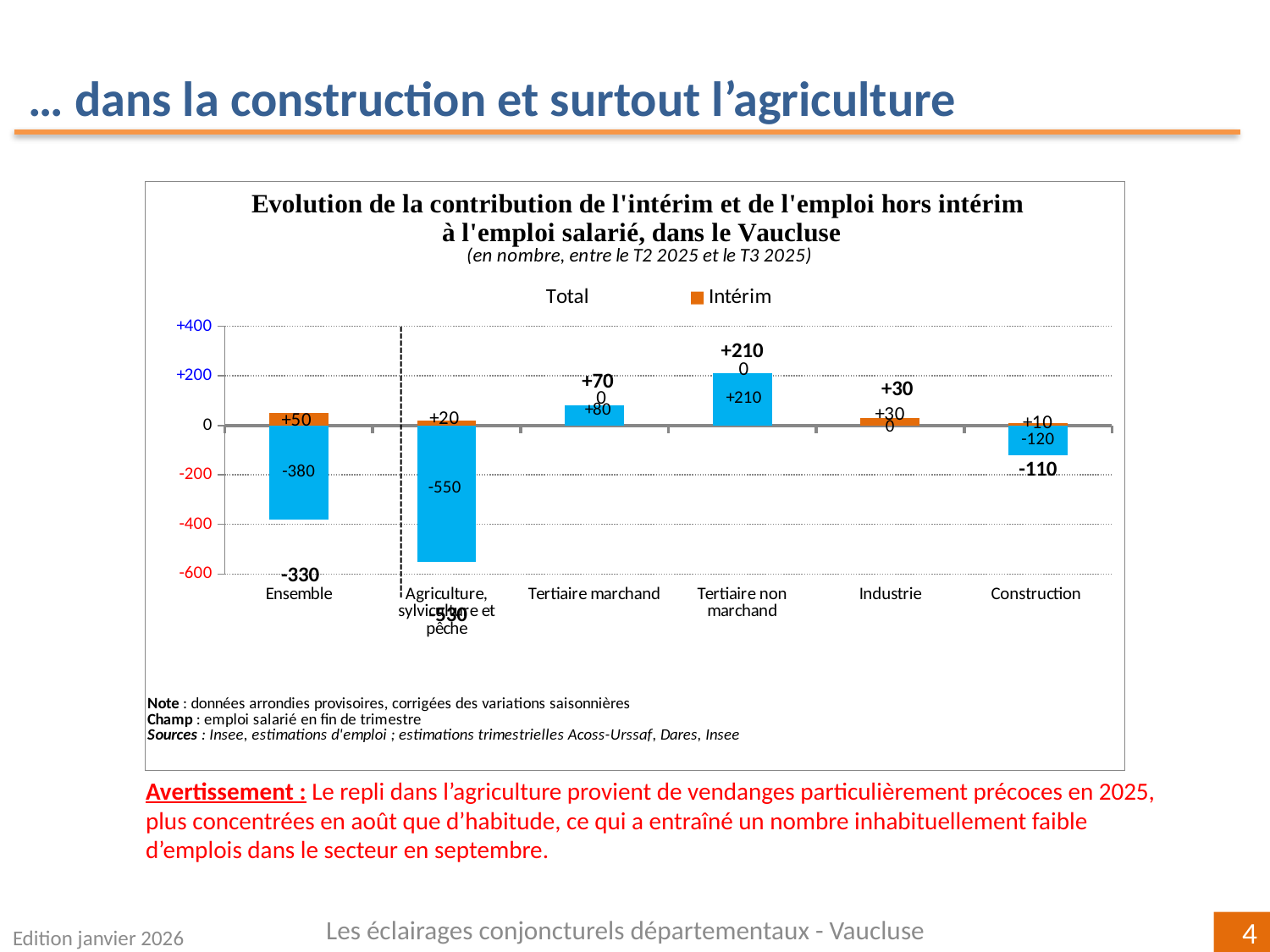
What is the Intérim value shown for Industrie? +30 Which has the larger blue bar value, Tertiaire marchand or Tertiaire non marchand? Tertiaire non marchand What is the bold total value shown for Tertiaire marchand? +70 What is the Intérim value shown for Ensemble? +50 What is the difference between the Intérim value for Ensemble and the Intérim value for Agriculture, sylviculture et pêche? 30 What kind of chart is this? Bar chart How many entries does the legend list? 2 Which category has the lowest bold total value? Agriculture, sylviculture et pêche How many categories are shown on the x axis? 6 What value is labelled on the blue bar for Agriculture, sylviculture et pêche? -550 Which category has the highest bold total value? Tertiaire non marchand What is the bold total value shown for Construction? -110